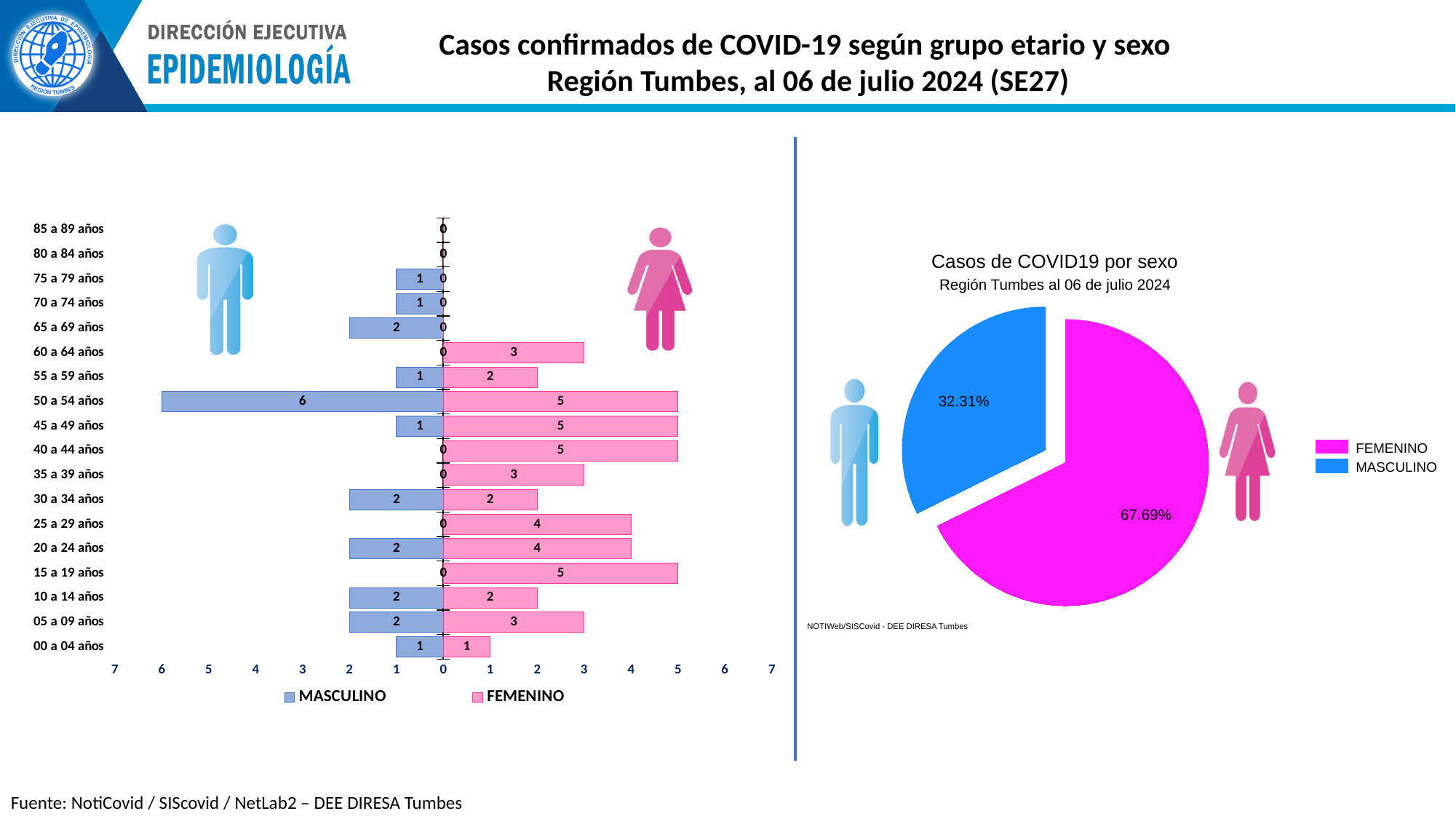
In the left bar chart, how many FEMENINO cases are in the 15 a 19 años group? 5 In the pie chart 'Casos de COVID19 por sexo', what share of cases is MASCULINO? 32.31% In the left bar chart, what is the total number of cases (MASCULINO plus FEMENINO) in the 50 a 54 años group? 11 In the left bar chart, how many MASCULINO cases are in the 50 a 54 años group? 6 How many age groups are shown on the left bar chart? 18 In the left bar chart, which age group has the highest number of MASCULINO cases? 50 a 54 años In the left bar chart, what is the difference between MASCULINO and FEMENINO cases in the 45 a 49 años group? 4 In the left bar chart, how many FEMENINO cases are in the 60 a 64 años group? 3 In the pie chart 'Casos de COVID19 por sexo', what share of cases is FEMENINO? 67.69% What type of chart is the chart titled 'Casos de COVID19 por sexo'? Pie chart How many series does the legend of the left bar chart list? 2 In the left bar chart, which is larger in the 20 a 24 años group, MASCULINO or FEMENINO? FEMENINO